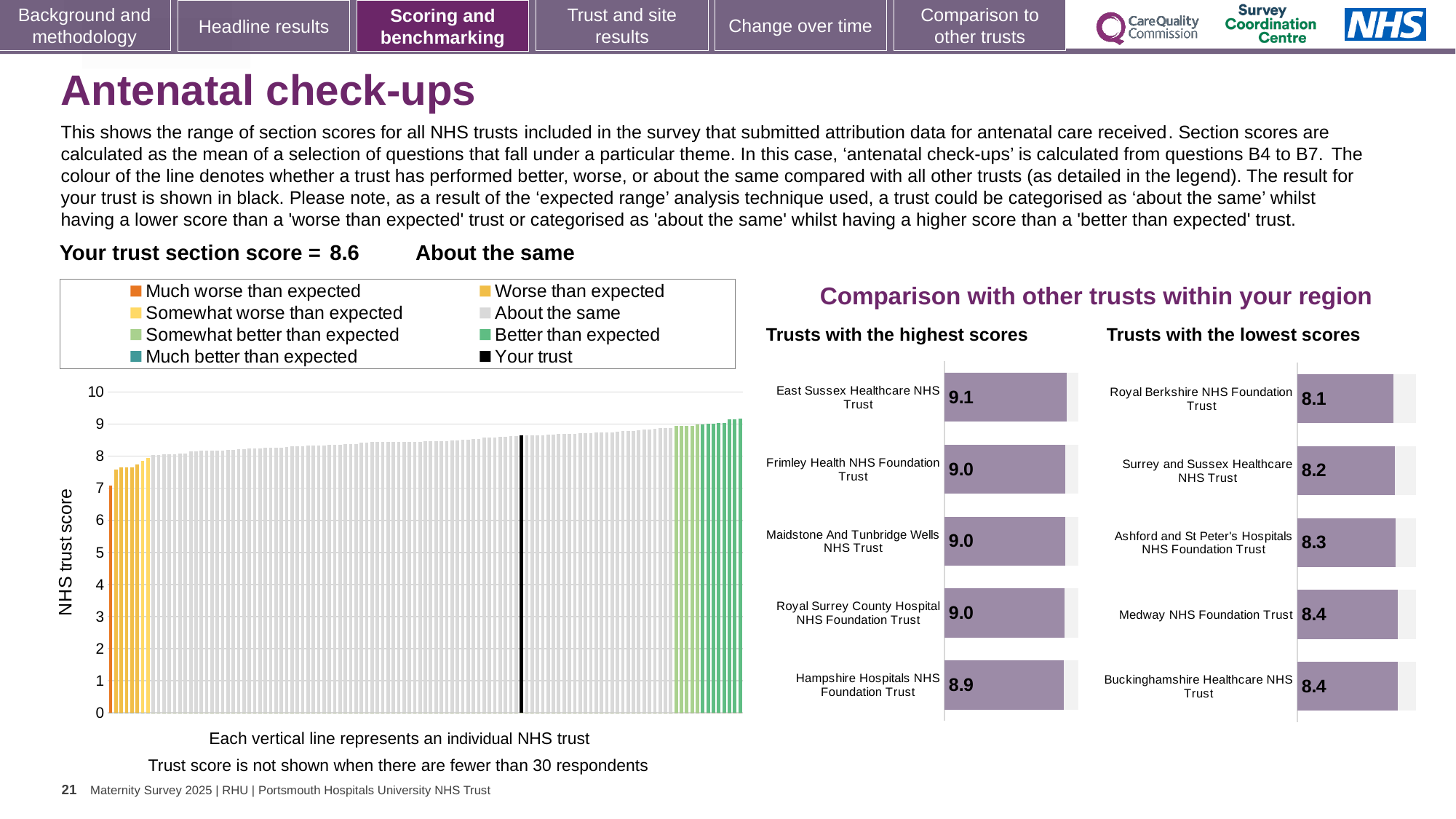
What kind of chart is the large chart on the left showing NHS trust scores? bar chart In the large chart on the left, do the trust scores rise or fall from left to right along the x axis? rise In the 'Trusts with the lowest scores' chart, which trust has the lowest score? Royal Berkshire NHS Foundation Trust In the 'Trusts with the highest scores' chart, which trust has the lowest score? Hampshire Hospitals NHS Foundation Trust How many entries does the legend above the large chart on the left list? 8 In the large chart on the left, is the value for the black 'Your trust' bar greater or less than 8? greater In the 'Trusts with the lowest scores' chart, which has the larger score: Ashford and St Peter's Hospitals NHS Foundation Trust or Surrey and Sussex Healthcare NHS Trust? Ashford and St Peter's Hospitals NHS Foundation Trust In the large chart on the left, what colour represents 'Your trust'? black How many trusts are shown in the 'Trusts with the lowest scores' chart? 5 In the 'Trusts with the highest scores' chart, what is the score for East Sussex Healthcare NHS Trust? 9.1 In the 'Trusts with the highest scores' chart, what is the difference between the scores of East Sussex Healthcare NHS Trust and Hampshire Hospitals NHS Foundation Trust? 0.2 In the 'Trusts with the lowest scores' chart, what is the score for Medway NHS Foundation Trust? 8.4